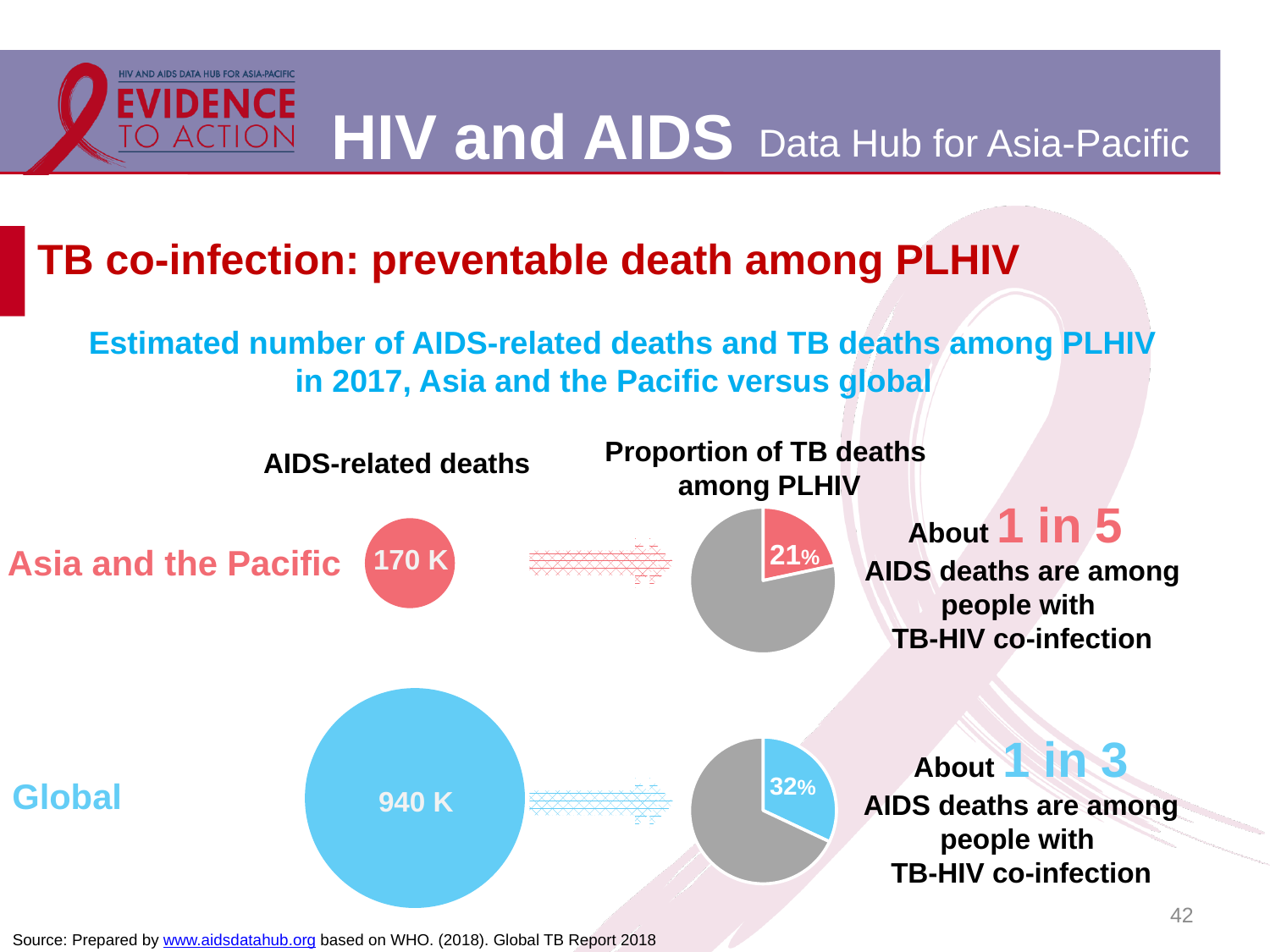
What is the estimated number of AIDS-related deaths shown for Global? 940 K What is the difference in percentage points between the Global proportion of TB deaths among PLHIV and the Asia and the Pacific proportion? 11 percentage points In the 'Proportion of TB deaths among PLHIV' pie chart for Asia and the Pacific, what proportion of AIDS deaths are TB deaths? 21% What kind of chart is used to show the proportion of TB deaths among PLHIV? Pie chart Which has more AIDS-related deaths, Asia and the Pacific or Global? Global In the 'Proportion of TB deaths among PLHIV' pie chart for Global, what proportion is shown? 32% How many pie charts are shown on the slide? 2 What is the estimated number of AIDS-related deaths shown for Asia and the Pacific? 170 K What colour is the 32% slice in the Global pie chart? Blue What is the title of the chart on the slide? Estimated number of AIDS-related deaths and TB deaths among PLHIV in 2017, Asia and the Pacific versus global Which has the higher proportion of TB deaths among PLHIV, Asia and the Pacific or Global? Global